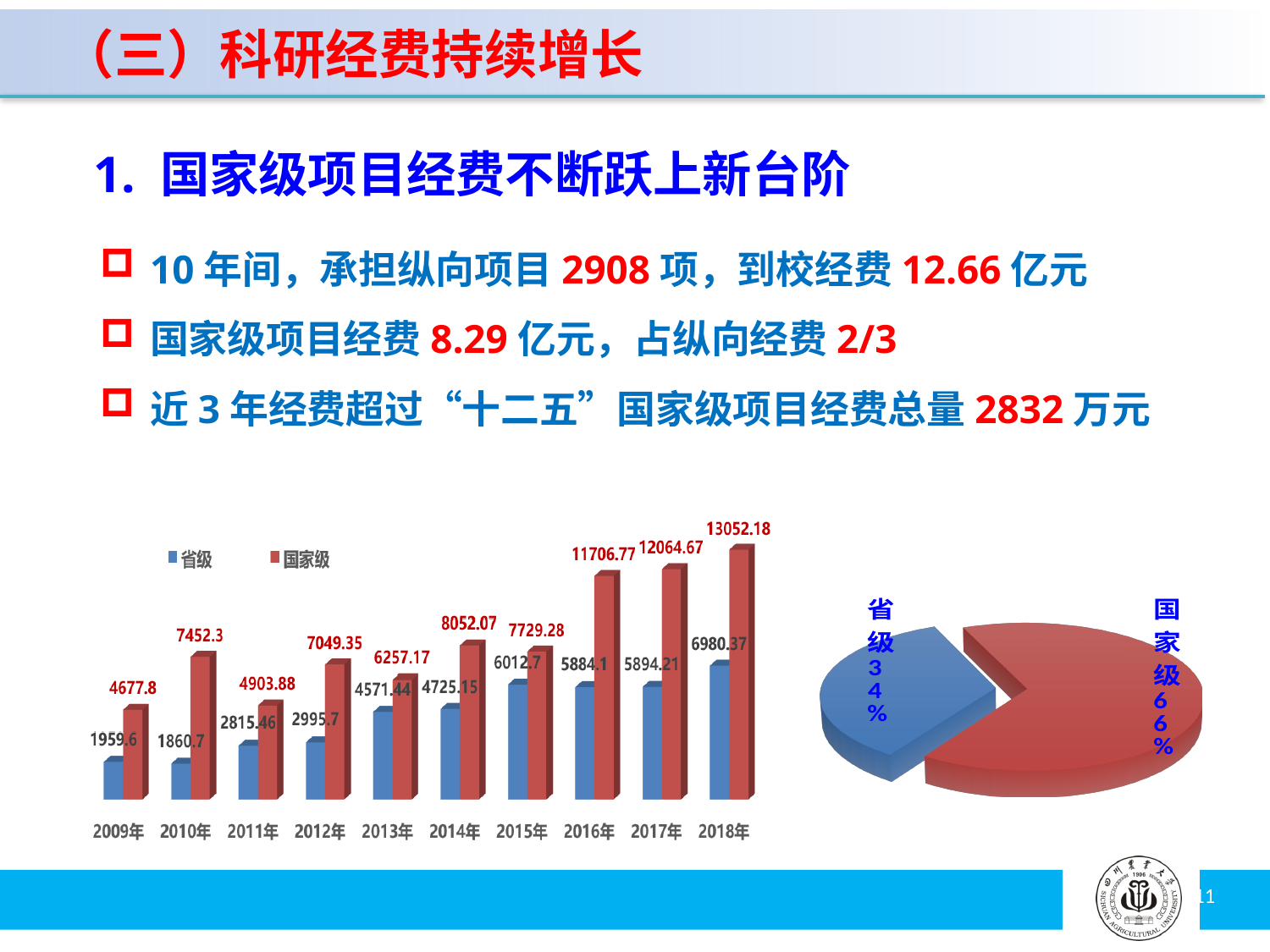
How many series does the legend of the bar chart on the left list? 2 How many years are shown on the x axis of the bar chart on the left? 10 In the bar chart on the left, which year has the lowest 省级 value? 2010年 In the bar chart on the left, which is larger in 2011年: 省级 or 国家级? 国家级 In the pie chart on the right, which slice is larger: 省级 or 国家级? 国家级 What kind of chart is shown on the left of the slide? bar chart In the bar chart on the left, what is the value for 国家级 in 2010年? 7452.3 In the bar chart on the left, what is the value for 国家级 in 2018年? 13052.18 In the bar chart on the left, what is the value for 省级 in 2013年? 4571.44 In the bar chart on the left, which year has the highest 国家级 value? 2018年 In the pie chart on the right, what share does 国家级 have? 66% In the bar chart on the left, what is the difference between the 国家级 and 省级 values in 2018年? 6071.81